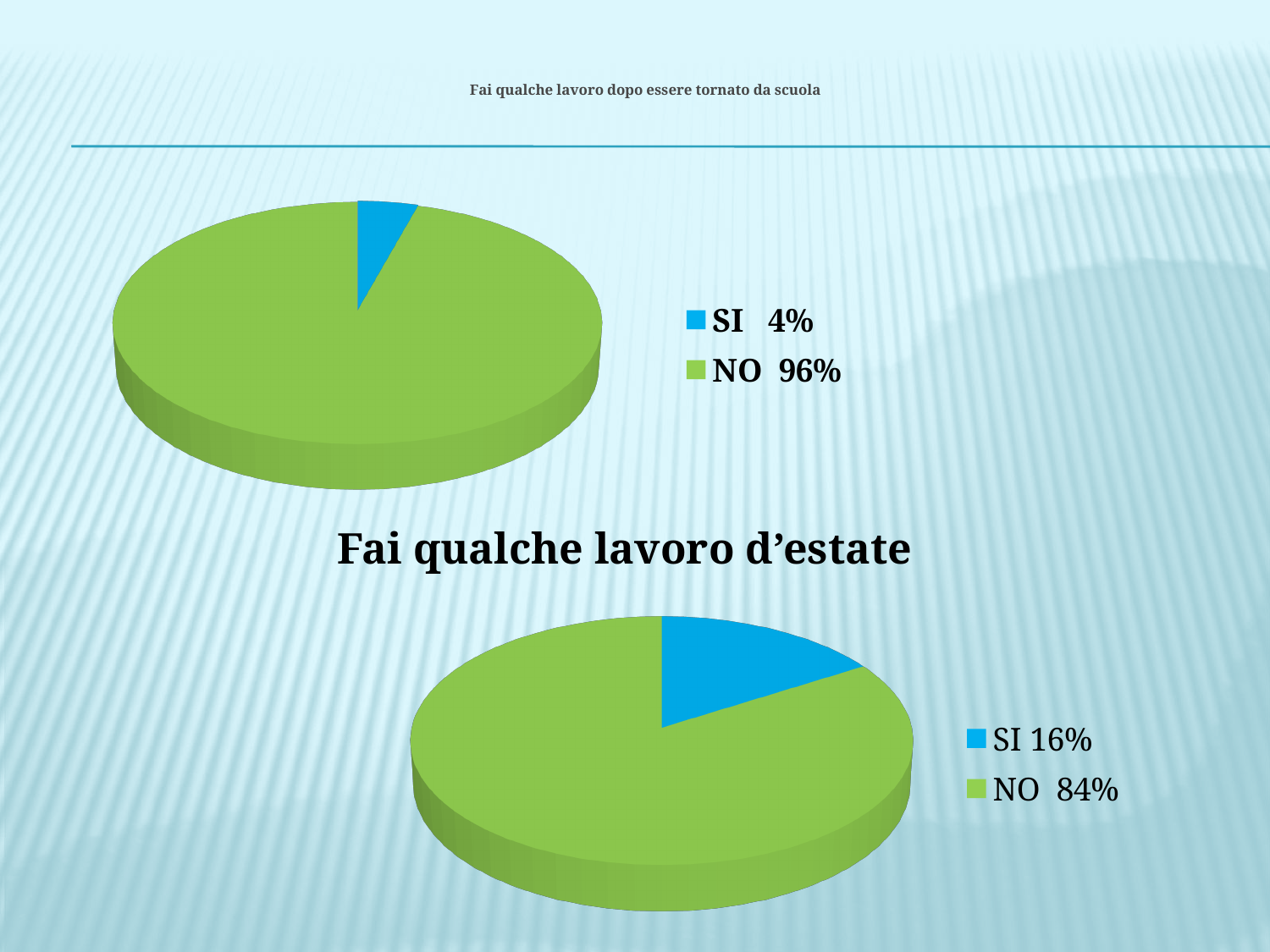
In the bottom chart titled 'Fai qualche lavoro d'estate', what colour represents the SI slice? blue In the bottom chart titled 'Fai qualche lavoro d'estate', what percentage is shown for NO? 84% What type of chart is the bottom chart titled 'Fai qualche lavoro d'estate'? pie chart In the top chart titled 'Fai qualche lavoro dopo essere tornato da scuola', what percentage is shown for SI? 4% In the top chart titled 'Fai qualche lavoro dopo essere tornato da scuola', what is the difference between the NO and SI percentages? 92% Which chart has the larger SI share, the top chart or the bottom chart? the bottom chart In the bottom chart titled 'Fai qualche lavoro d'estate', what is the difference between the NO and SI percentages? 68% In the top chart titled 'Fai qualche lavoro dopo essere tornato da scuola', what percentage is shown for NO? 96% How many categories does the legend of the top chart titled 'Fai qualche lavoro dopo essere tornato da scuola' list? 2 In the bottom chart titled 'Fai qualche lavoro d'estate', which category has the smallest share? SI In the bottom chart titled 'Fai qualche lavoro d'estate', what percentage is shown for SI? 16% In the top chart titled 'Fai qualche lavoro dopo essere tornato da scuola', which category has the largest share? NO